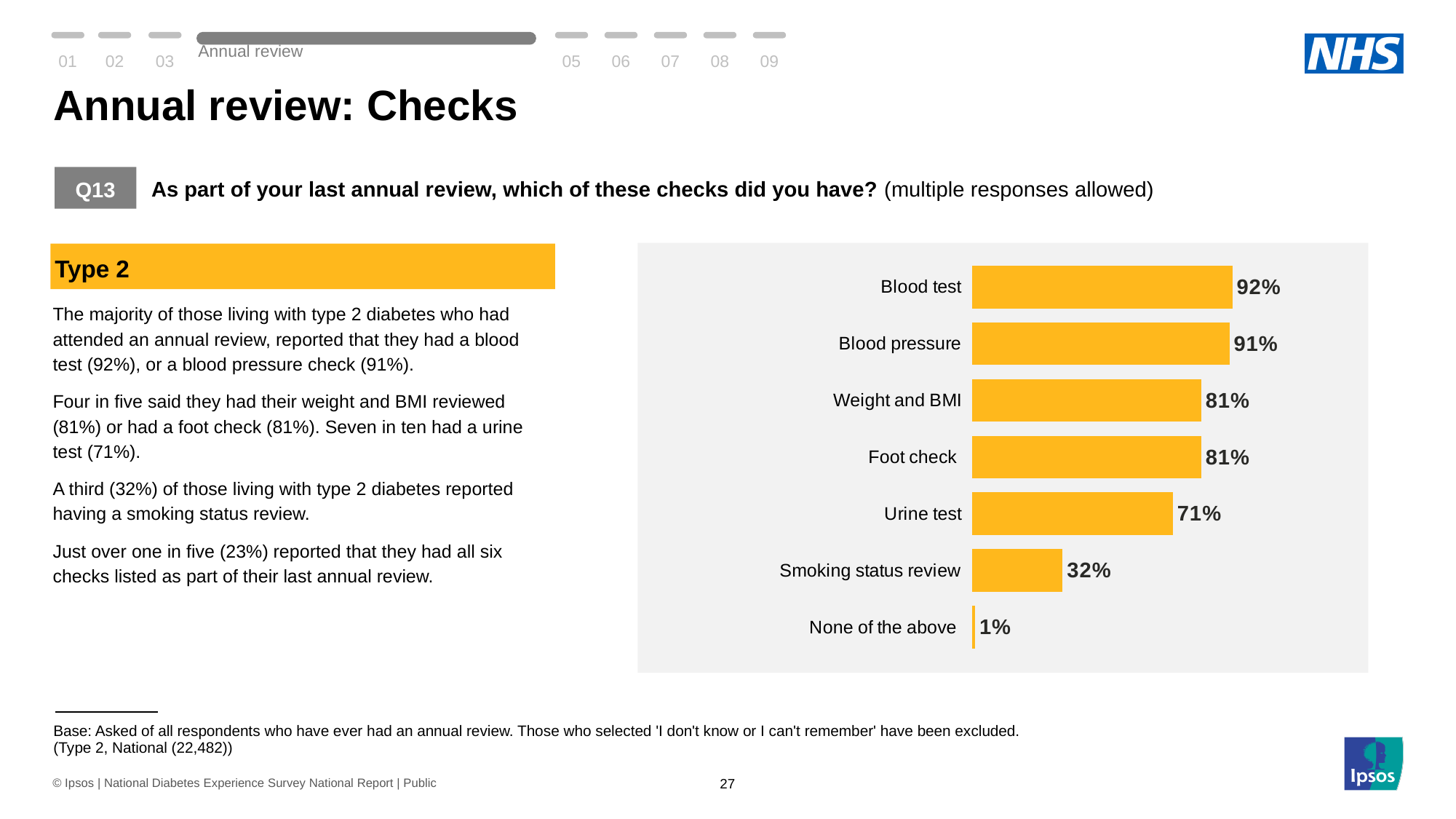
Which two checks share the same value of 81%? Weight and BMI and Foot check What is the value shown for None of the above? 1% How many categories are shown in the chart? 7 Which category has the lowest value in the chart? None of the above Which check has the highest percentage in the chart? Blood test What percentage is shown for Smoking status review? 32% What percentage of respondents reported having a blood test as part of their last annual review? 92% What is the difference in percentage points between Blood test and Smoking status review? 60 What is the difference in percentage points between Weight and BMI and Urine test? 10 What type of chart is shown on the slide? Bar chart Which is larger, the value for Blood pressure or the value for Foot check? Blood pressure What is the value shown for Urine test? 71%